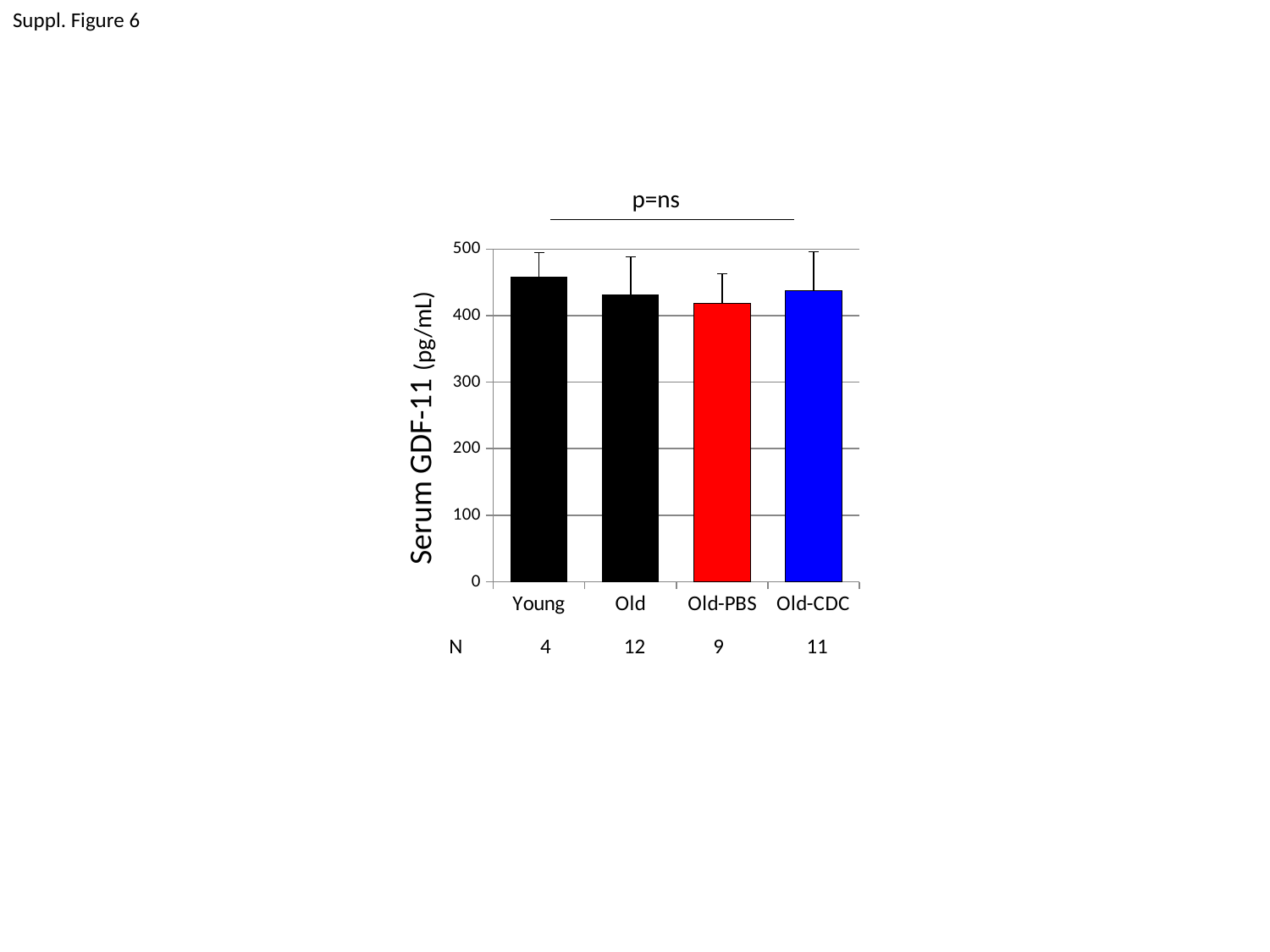
Is the value for Young greater or less than 400? greater Which is larger, the value for Young or the value for Old-PBS? Young What is the N shown for the Old-CDC group? 11 Which category has the highest serum GDF-11 value? Young What colour is the bar for Old-PBS? red Is the value for Old greater or less than 300? greater Is the value for Old-PBS greater or less than 400? greater What kind of chart is shown on the slide? bar chart How many categories are plotted on the x axis? 4 What is the N shown for the Old group? 12 What is the label of the y axis? Serum GDF-11 (pg/mL)